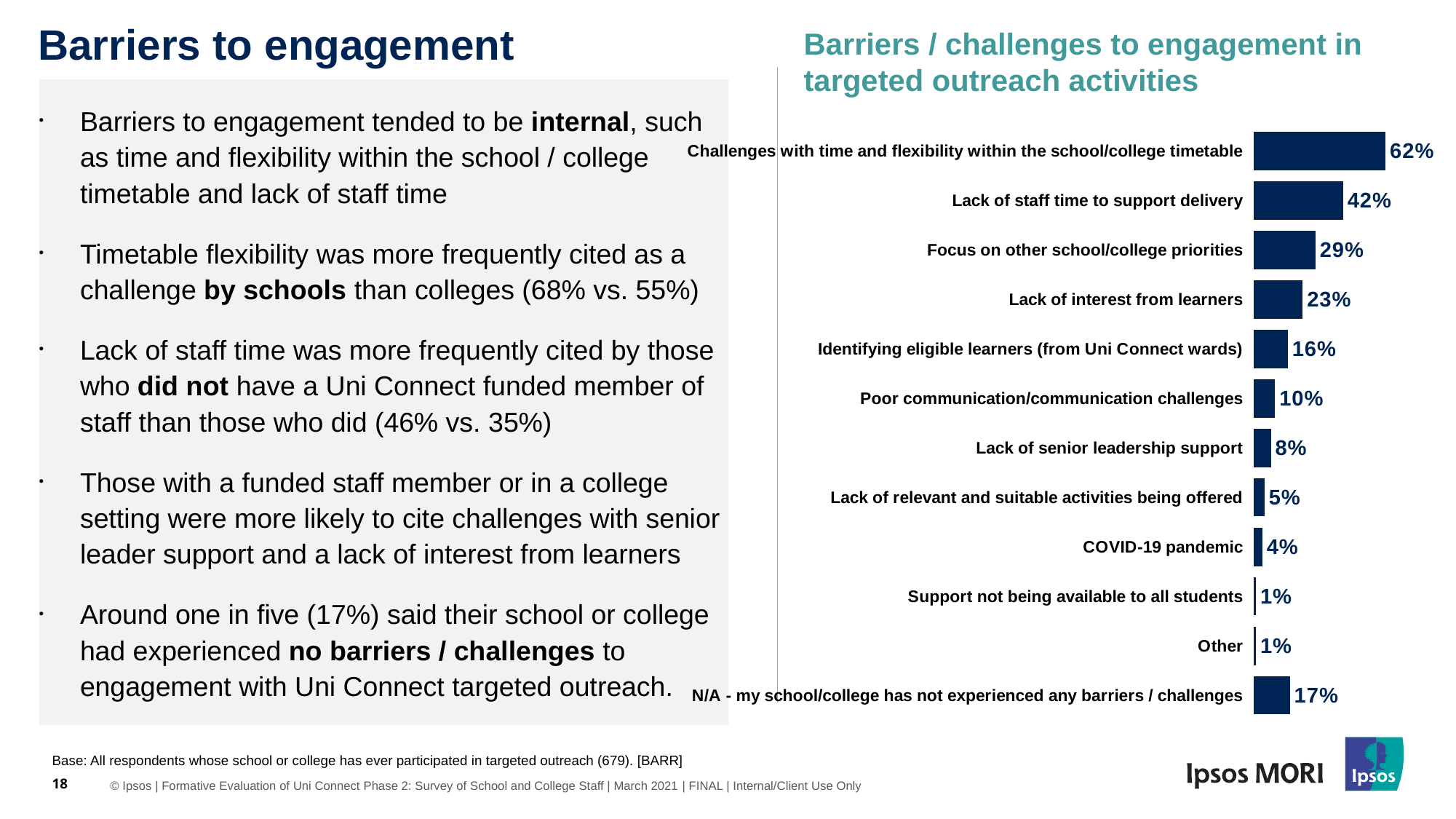
What percentage said their school/college has not experienced any barriers / challenges (N/A)? 17% What type of chart is used to show the barriers / challenges to engagement? Bar chart Which barrier has the highest percentage? Challenges with time and flexibility within the school/college timetable What is the title of the chart? Barriers / challenges to engagement in targeted outreach activities What percentage cited lack of interest from learners? 23% What is the difference in percentage points between 'Challenges with time and flexibility within the school/college timetable' and 'Lack of staff time to support delivery'? 20 percentage points What percentage cited the COVID-19 pandemic as a barrier? 4% What percentage cited lack of staff time to support delivery? 42% What percentage cited challenges with time and flexibility within the school/college timetable as a barrier? 62% Which is larger: the percentage for 'Focus on other school/college priorities' or for 'Lack of interest from learners'? Focus on other school/college priorities How many categories are shown in the chart? 12 What is the difference between 'Lack of senior leadership support' and 'COVID-19 pandemic'? 4 percentage points